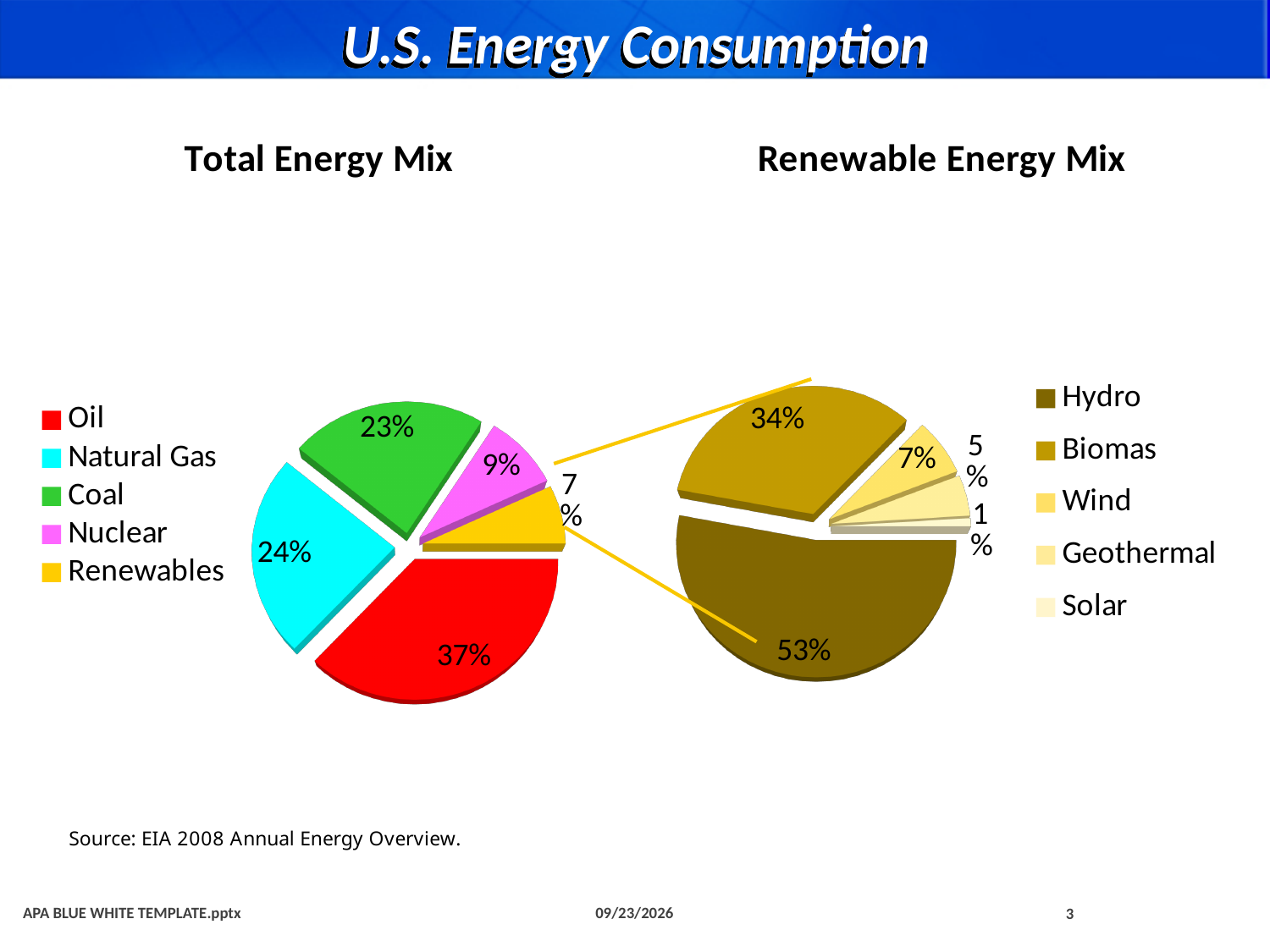
In the Total Energy Mix chart, what share does Oil have? 37% In the Renewable Energy Mix chart, what share does Wind have? 7% In the Total Energy Mix chart, how many categories are shown? 5 In the Renewable Energy Mix chart, which category has the smallest share? Solar What type of chart is used for the Total Energy Mix? Pie chart In the Total Energy Mix chart, which category has the largest share? Oil In the Total Energy Mix chart, what is the difference in percentage points between Oil and Coal? 14 In the Renewable Energy Mix chart, which is larger, Biomas or Wind? Biomas In the Renewable Energy Mix chart, what share does Hydro have? 53% In the Renewable Energy Mix chart, what is the difference in percentage points between Hydro and Biomas? 19 In the Total Energy Mix chart, what share does Natural Gas have? 24% In the Total Energy Mix chart, which category has the smallest share? Renewables